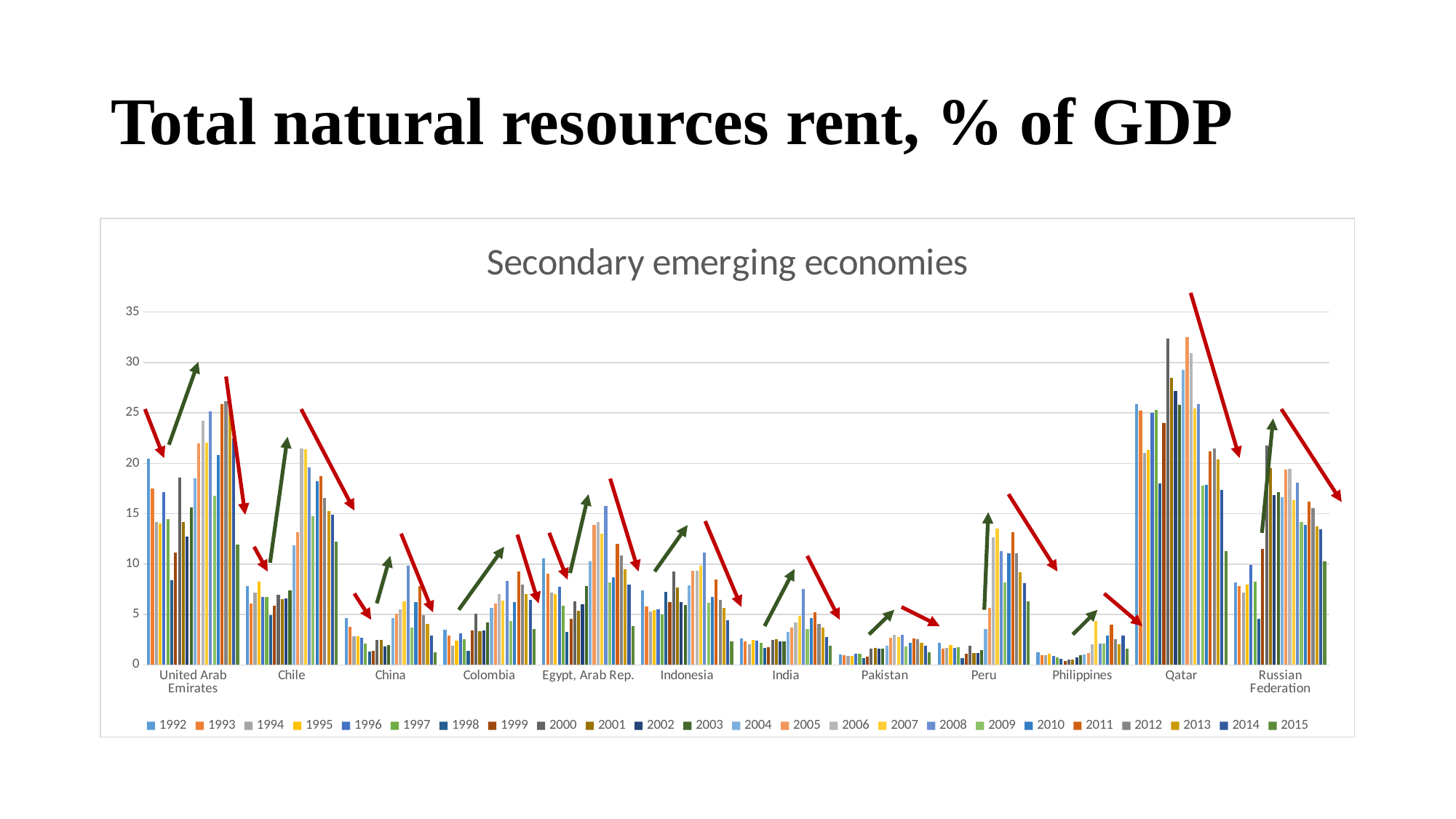
Are all the bars for Philippines greater or less than 10? less Is the tallest bar for Qatar greater or less than 30? greater Is the tallest bar for United Arab Emirates greater or less than 25? greater Which country has taller bars overall, Russian Federation or India? Russian Federation Which country has taller bars overall, Qatar or Pakistan? Qatar What is the first year listed in the chart legend? 1992 What is the title of the chart? Secondary emerging economies How many countries (categories) are shown on the x axis of the chart? 12 How many series (years) does the chart legend list? 24 What type of chart is shown on the slide? Bar chart Which country has the tallest bars in the chart? Qatar